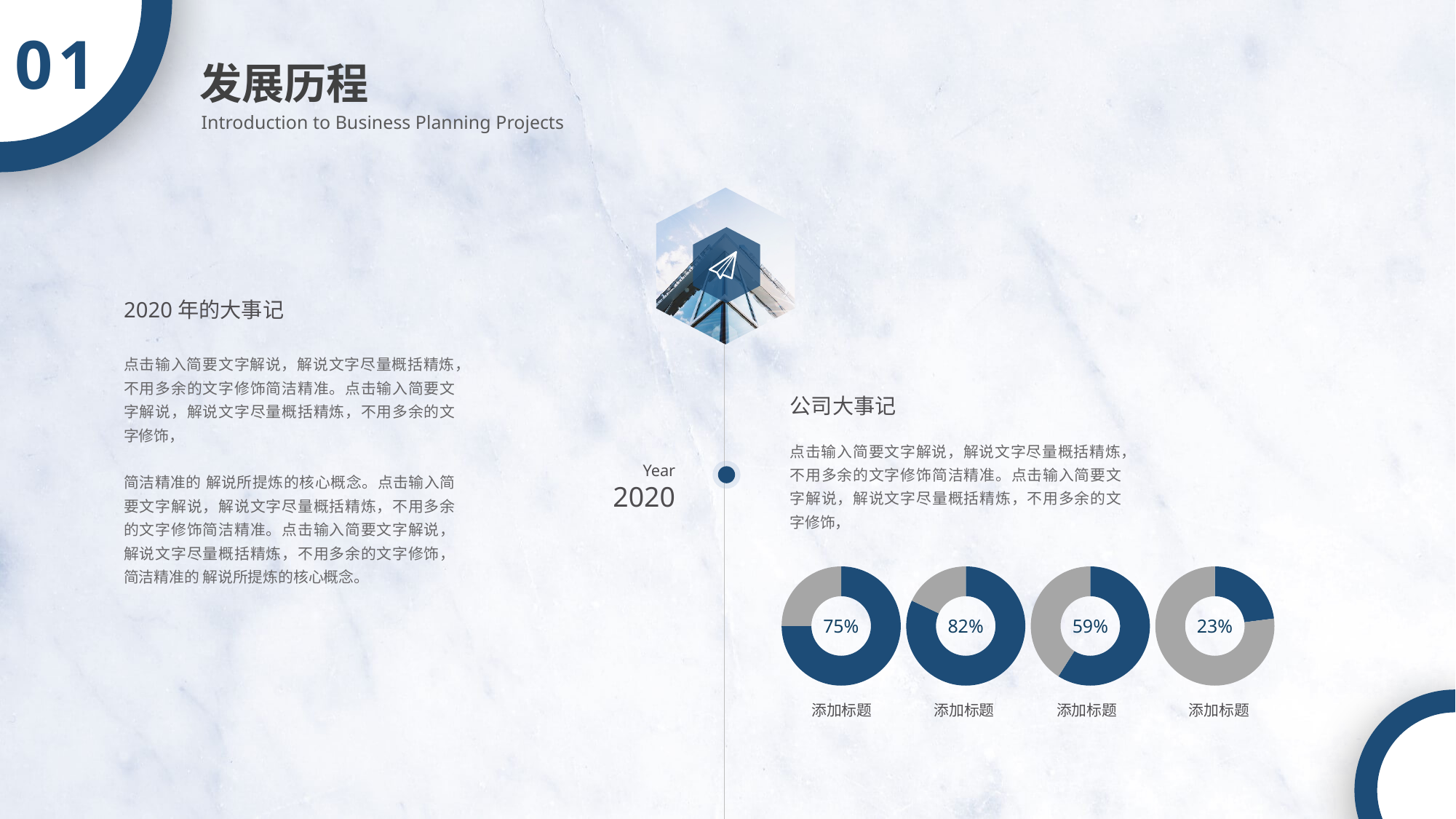
Which is larger, the percentage in the first donut chart or the percentage in the third donut chart? The first donut chart (75%) What value is shown in the centre of the fourth (rightmost) donut chart? 23% What value is shown in the centre of the first (leftmost) donut chart? 75% What type of chart is used to display the four percentages on the slide? Donut chart What is the difference between the percentage in the first donut chart and the percentage in the third donut chart? 16% What colour is used for the filled (percentage) portion of each donut chart? Dark blue What value is shown in the centre of the second donut chart from the left? 82% What is the difference between the percentage in the second donut chart and the percentage in the fourth donut chart? 59% What value is shown in the centre of the third donut chart from the left? 59% Which of the four donut charts shows the lowest percentage? The rightmost one (23%) Which of the four donut charts shows the highest percentage? The second from the left (82%) How many donut charts are shown on the slide? 4